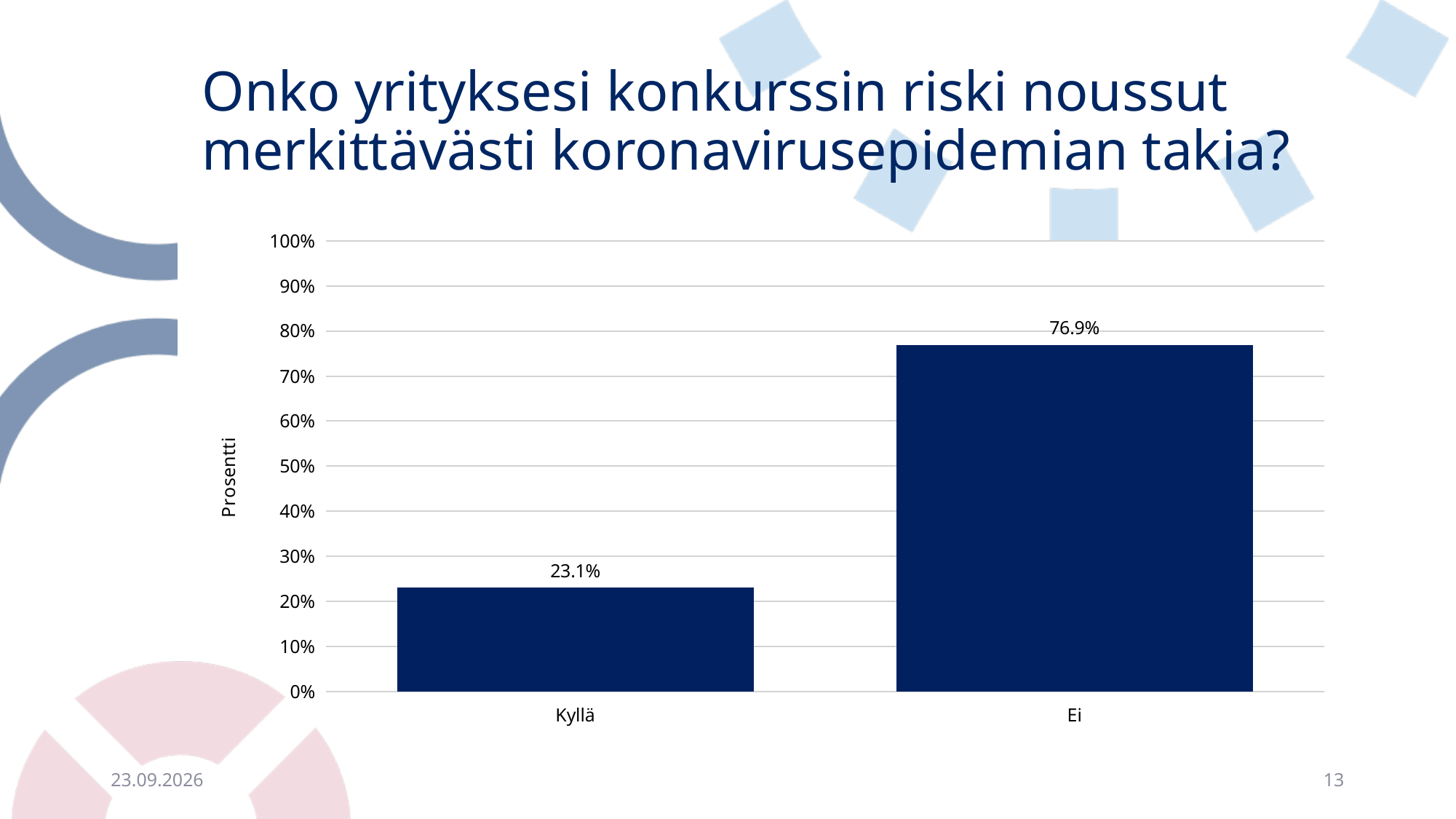
What is the value for Ei? 76.9% How many categories are shown on the x axis? 2 What is the difference between the values for Ei and Kyllä? 53.8% Is the value for Ei greater or less than 70%? greater What is the maximum value shown on the vertical axis? 100% What is the label of the vertical axis? Prosentti Is the value for Kyllä greater or less than 30%? less Which is larger, the value for Kyllä or the value for Ei? Ei Which category has the lowest value? Kyllä What kind of chart is shown on the slide? bar chart What is the value for Kyllä? 23.1% Which category has the highest value? Ei